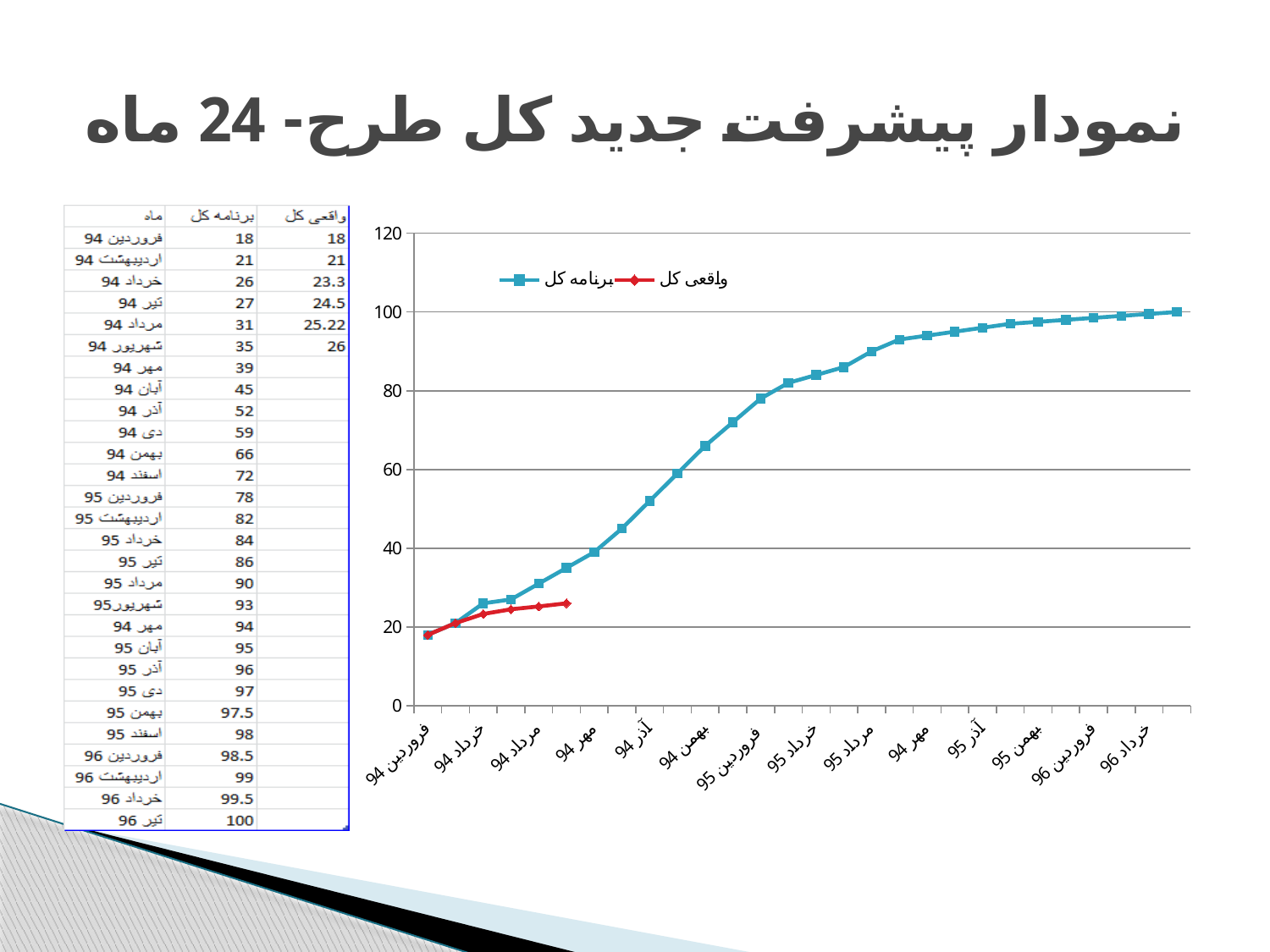
Is the برنامه کل value for فروردین 95 greater or less than 60? greater Which month has the highest value for the برنامه کل series? تیر 96 Does the برنامه کل series rise or fall along the x axis? rise How many series does the chart legend list? 2 What is the واقعی کل value for شهریور 94? 26 What are the two series named in the chart legend? برنامه کل and واقعی کل What is the برنامه کل value for فروردین 94? 18 For مرداد 94, which is larger: برنامه کل or واقعی کل? برنامه کل What is the difference between برنامه کل and واقعی کل for خرداد 94? 2.7 What kind of chart is shown on the slide? line chart How many data points does the واقعی کل series have? 6 Is the برنامه کل value for آذر 94 greater or less than 40? greater